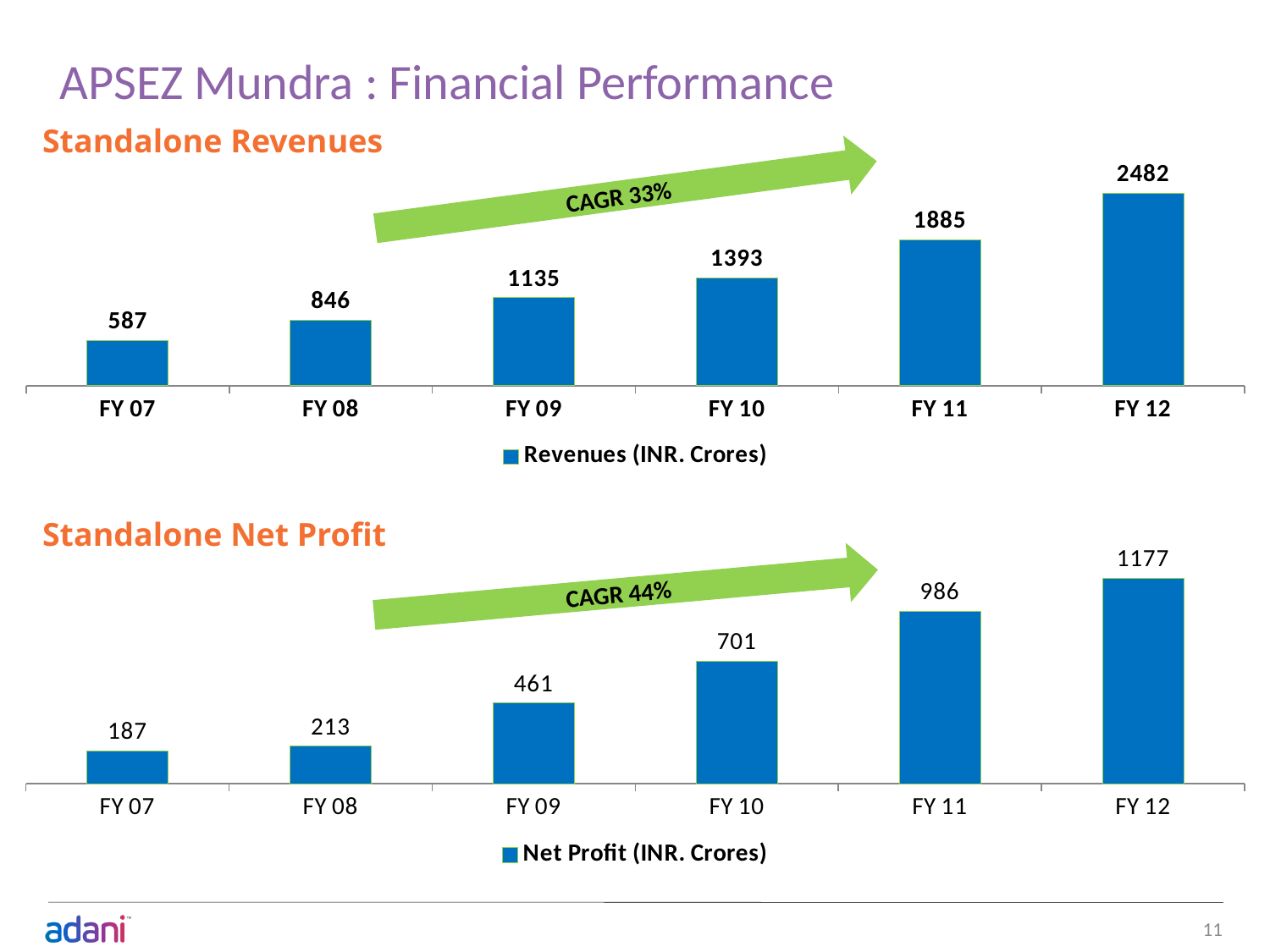
In the Standalone Net Profit chart, which fiscal year has the lowest net profit? FY 07 How many fiscal years are shown in the Standalone Revenues chart? 6 In the Standalone Revenues chart, what is the difference between the revenue for FY 12 and FY 11? 597 In the Standalone Net Profit chart, which is larger, the net profit for FY 08 or FY 09? FY 09 In the Standalone Net Profit chart, what is the net profit for FY 09? 461 How many series does the legend of the Standalone Net Profit chart list? 1 What kind of chart is the Standalone Revenues chart? Bar chart What CAGR is shown on the Standalone Revenues chart? 33% In the Standalone Revenues chart, what is the revenue for FY 10? 1393 In the Standalone Net Profit chart, what is the difference between the net profit for FY 10 and FY 09? 240 In the Standalone Net Profit chart, do the values rise or fall from FY 07 to FY 12? Rise In the Standalone Revenues chart, which fiscal year has the highest revenue? FY 12